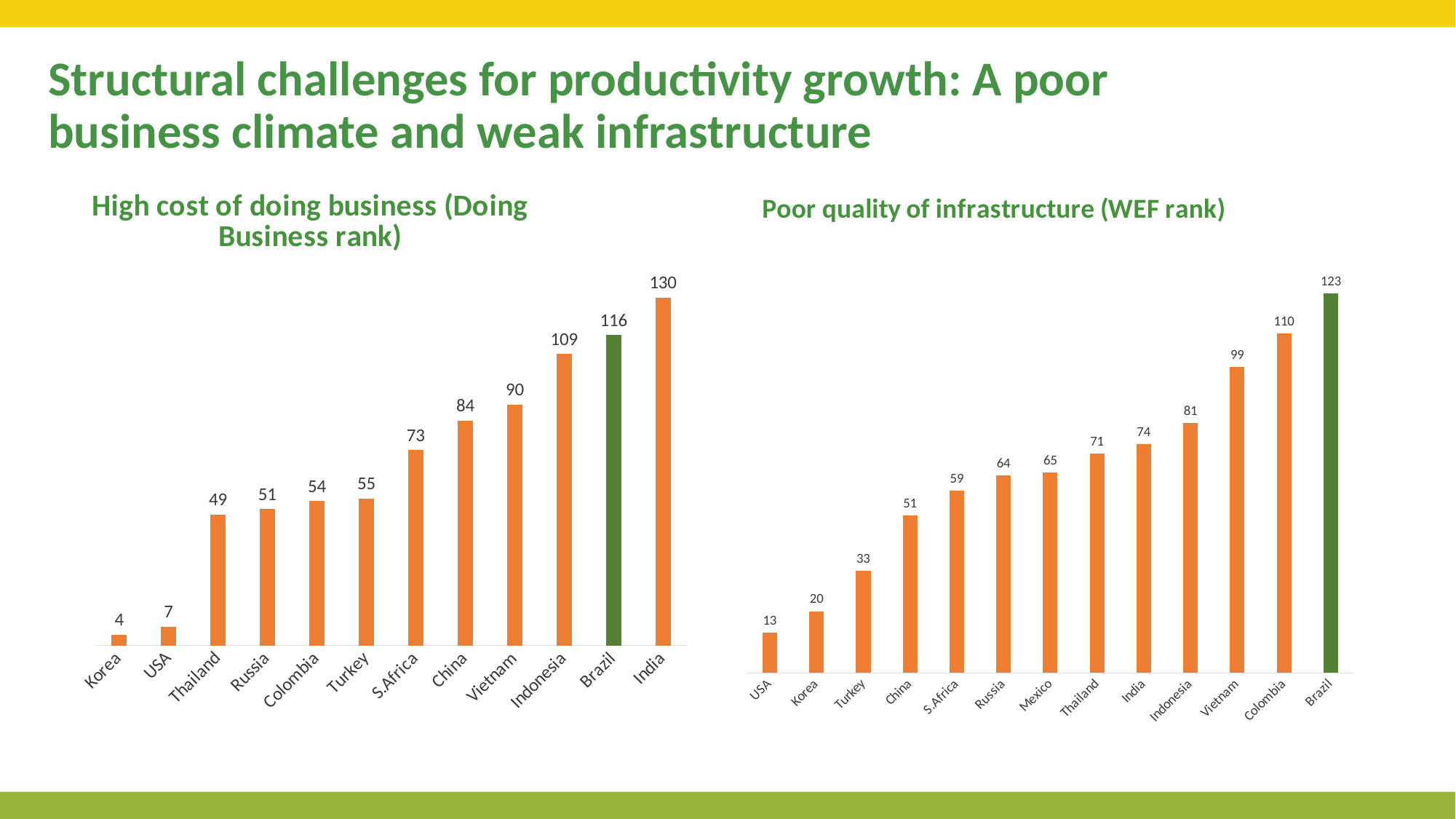
In the 'Poor quality of infrastructure (WEF rank)' chart, which country has the highest value? Brazil In the 'High cost of doing business (Doing Business rank)' chart, which country has the highest value? India In the 'High cost of doing business (Doing Business rank)' chart, what is the value for Brazil? 116 In the 'High cost of doing business (Doing Business rank)' chart, which country has the lowest value? Korea In the 'Poor quality of infrastructure (WEF rank)' chart, which has a larger value, Vietnam or Indonesia? Vietnam In the 'High cost of doing business (Doing Business rank)' chart, what is the difference between the values for India and Brazil? 14 In the 'Poor quality of infrastructure (WEF rank)' chart, what is the value for Mexico? 65 In the 'Poor quality of infrastructure (WEF rank)' chart, how many countries are shown? 13 What type of chart is the 'Poor quality of infrastructure (WEF rank)' chart? Bar chart In the 'High cost of doing business (Doing Business rank)' chart, how many countries are shown? 12 In the 'Poor quality of infrastructure (WEF rank)' chart, what is the difference between the values for Brazil and Colombia? 13 In the 'Poor quality of infrastructure (WEF rank)' chart, which country has the lowest value? USA